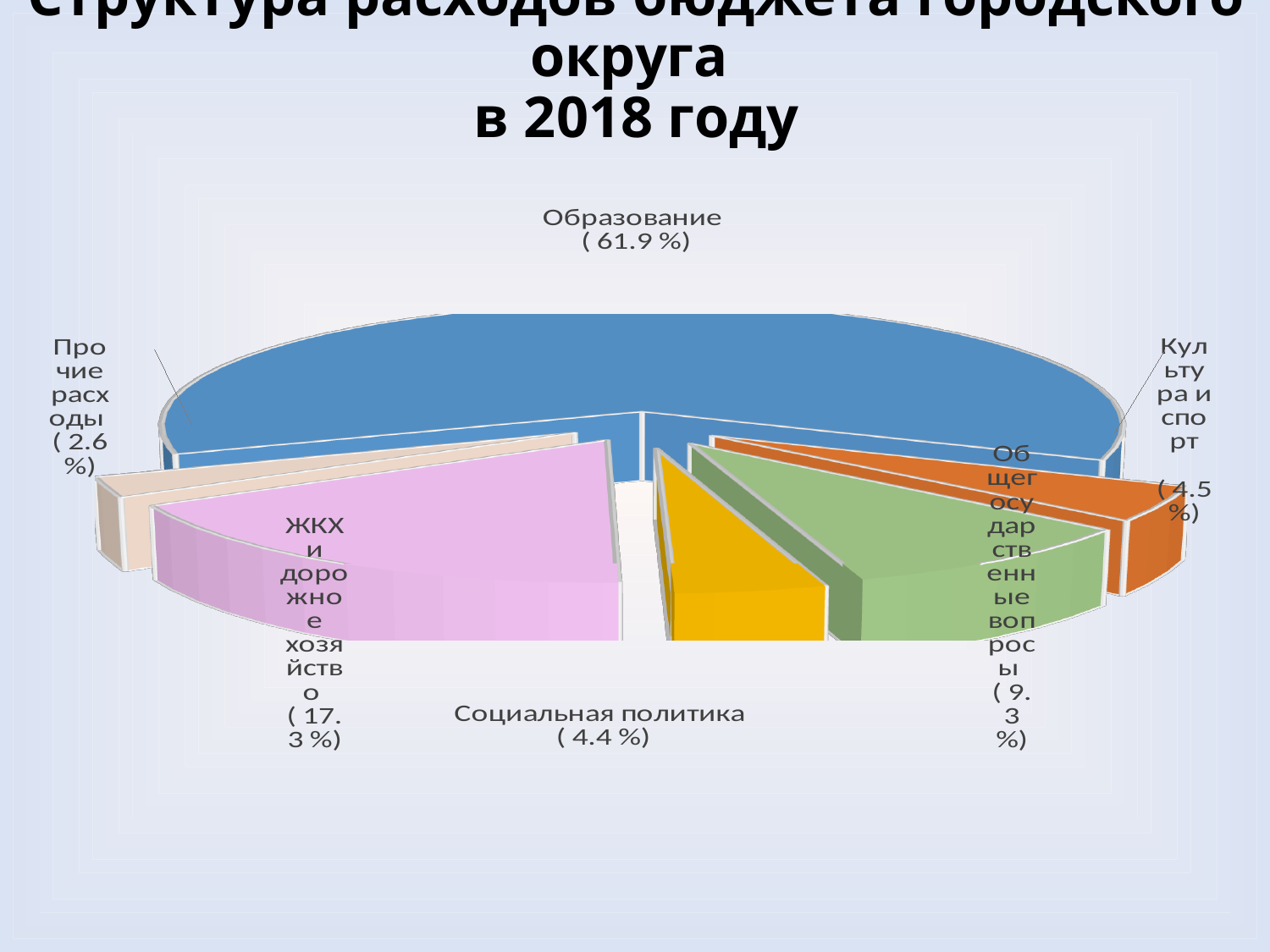
What kind of chart is shown on the slide? Pie chart What is the value shown for Общегосударственные вопросы? 9.3 % Which is larger: Общегосударственные вопросы or Культура и спорт? Общегосударственные вопросы What share is shown for Прочие расходы? 2.6 % By how many percentage points does Образование exceed ЖКХ и дорожное хозяйство? 44.6 What share of the budget expenditure does Образование account for? 61.9 % Which category has the largest share of the budget expenditure? Образование Which category has the smallest share of the budget expenditure? Прочие расходы What colour is the Образование slice? Blue What percentage is shown for Социальная политика? 4.4 % How many categories (slices) does the chart show? 6 What percentage is shown for ЖКХ и дорожное хозяйство? 17.3 %